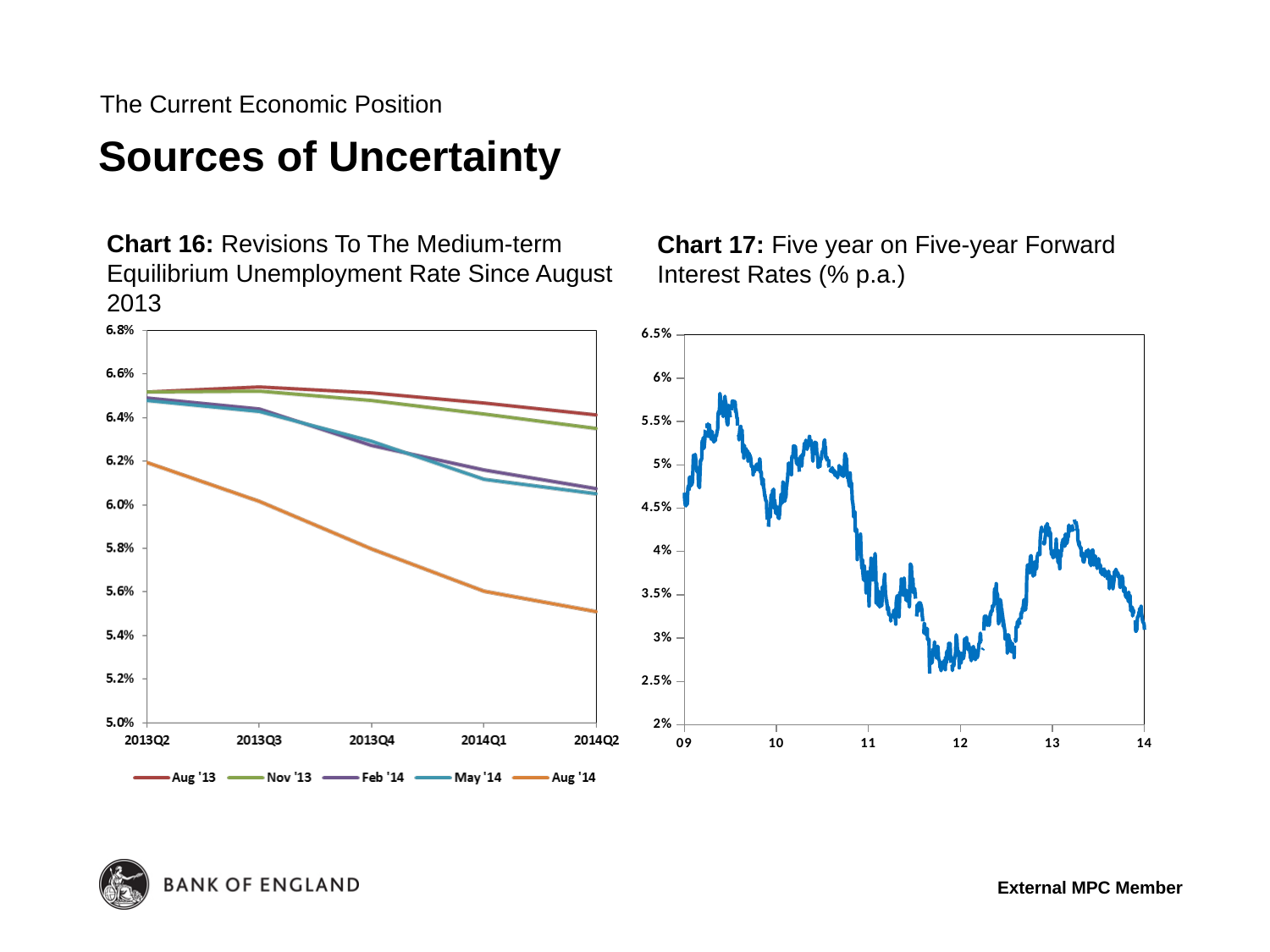
In Chart 17, is the value at the end of the series (at 14) greater or less than 3.5%? less In Chart 16, which series has the lowest values across all quarters? Aug '14 What kind of chart is Chart 16? line chart In Chart 17, is the lowest point of the line (around late 2011) greater or less than 3%? less How many quarters are shown on the x axis of Chart 16? 5 In Chart 16, is the Aug '13 value at 2013Q2 greater or less than 6.4%? greater In Chart 16, which is larger at 2014Q2: the Aug '13 value or the Aug '14 value? Aug '13 In Chart 16, which series has the highest value at 2014Q2? Aug '13 How many series does the legend of Chart 16 list? 5 In Chart 16, does the Aug '14 series rise or fall from 2013Q2 to 2014Q2? fall What is the title of Chart 17? Five year on Five-year Forward Interest Rates (% p.a.)